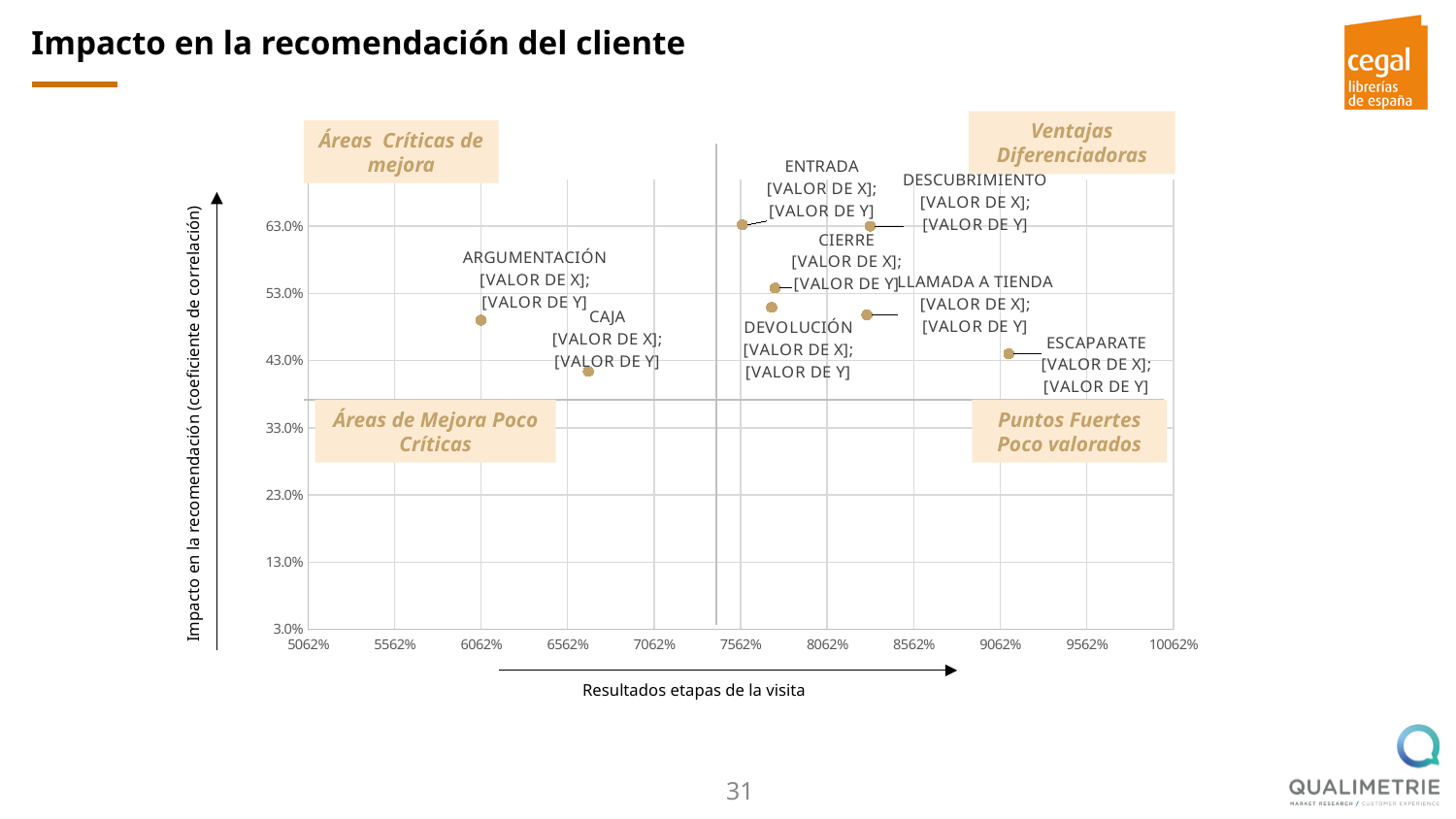
How many labelled data points are plotted on the chart? 8 Is the vertical-axis value for ARGUMENTACIÓN greater or less than 53.0%? less Which data point is furthest to the right on the horizontal axis? ESCAPARATE Is the vertical-axis value for CAJA greater or less than 33.0%? greater Is the vertical-axis value for ESCAPARATE greater or less than 53.0%? less What kind of chart is shown on the slide? Scatter chart Which data point has the lowest value on the vertical axis (Impacto en la recomendación)? CAJA Which data point is furthest to the left on the horizontal axis (Resultados etapas de la visita)? ARGUMENTACIÓN What is the label of the horizontal axis? Resultados etapas de la visita Which has the higher vertical-axis value, ARGUMENTACIÓN or CAJA? ARGUMENTACIÓN What is the title of the slide? Impacto en la recomendación del cliente